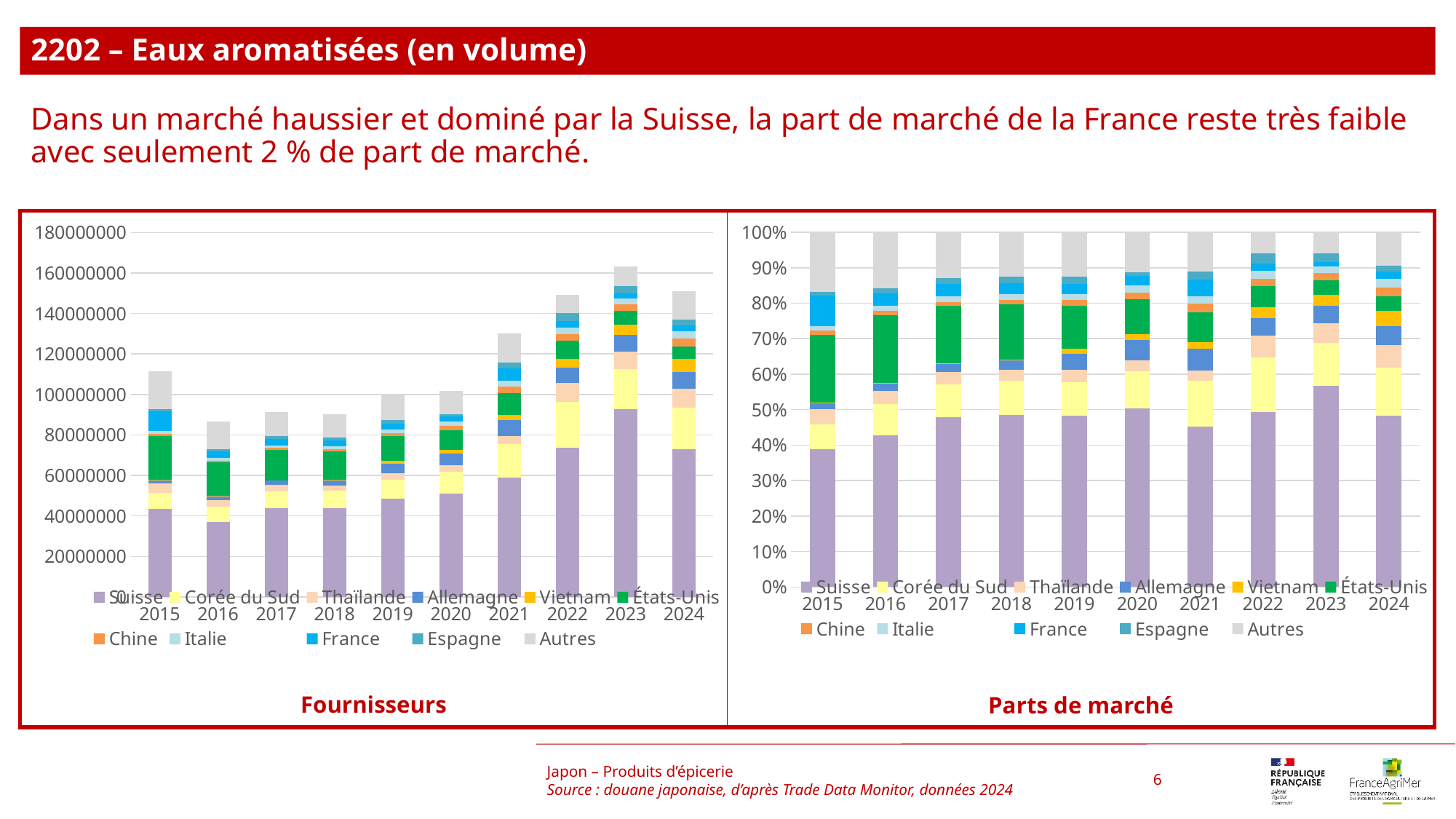
In the 'Parts de marché' chart, is the share of Suisse in 2024 greater or less than 50%? less In the 'Fournisseurs' chart, do the total bars generally rise or fall from 2018 to 2023? rise In the 'Fournisseurs' chart, which total bar is larger, 2023 or 2016? 2023 How many years are shown on the x axis of the 'Parts de marché' chart? 10 What kind of chart is the 'Fournisseurs' chart on the left? stacked bar chart In the 'Fournisseurs' chart, is the total bar for 2015 greater or less than 100000000? greater In the 'Fournisseurs' chart, is the total bar for 2016 greater or less than 100000000? less In the 'Fournisseurs' chart, which year has the tallest total bar? 2023 What is the title of the chart on the right of the slide? Parts de marché How many series does the legend of the 'Fournisseurs' chart list? 11